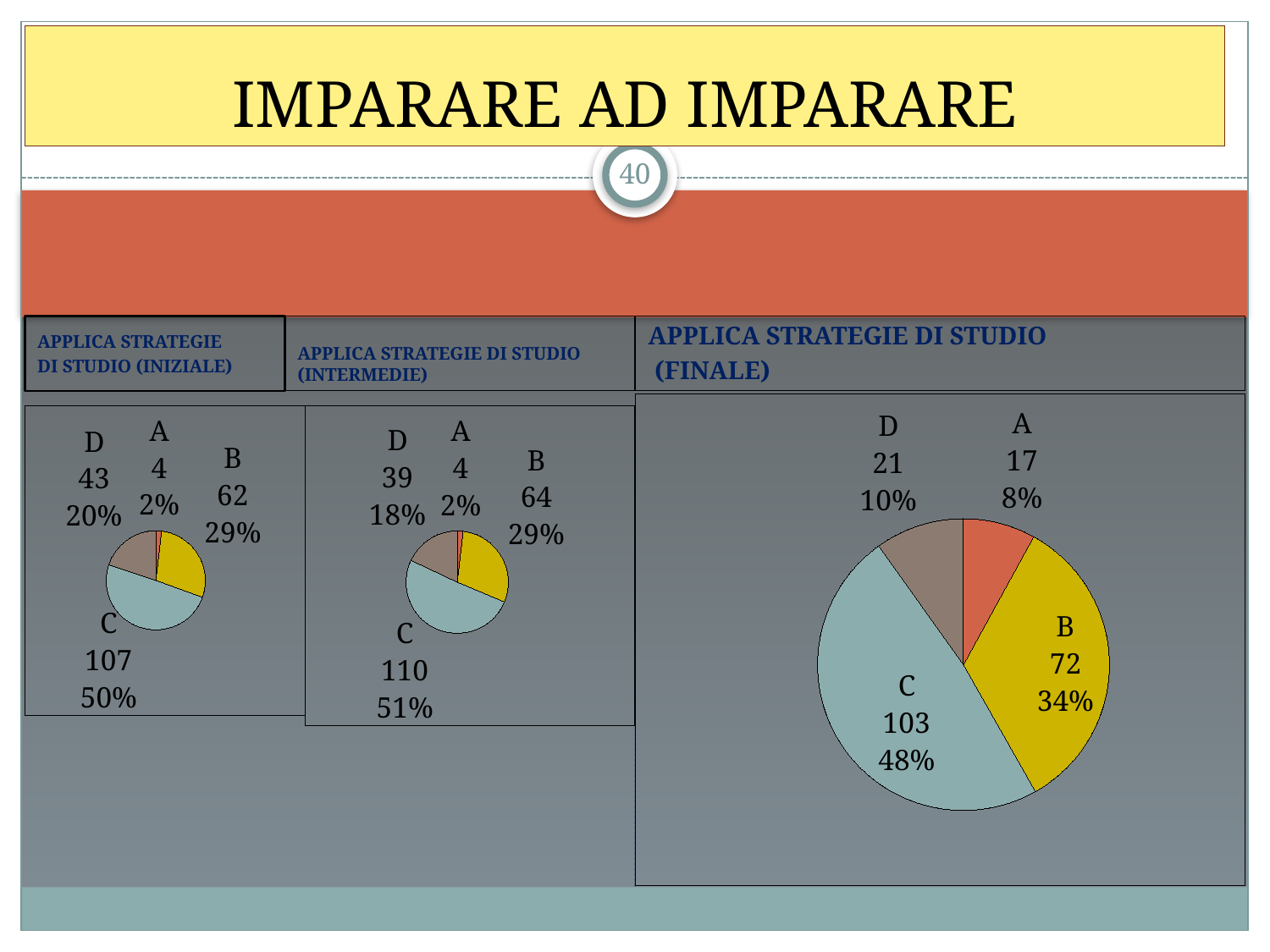
How many pie charts are shown on the slide? 3 In the APPLICA STRATEGIE DI STUDIO (FINALE) chart, what share of the pie does B represent? 34% What kind of chart is the APPLICA STRATEGIE DI STUDIO (INIZIALE) chart? Pie chart In the APPLICA STRATEGIE DI STUDIO (FINALE) chart, what is the difference between the values for C and B? 31 In the APPLICA STRATEGIE DI STUDIO (INIZIALE) chart, what is the value for D? 43 How many categories does the APPLICA STRATEGIE DI STUDIO (FINALE) chart show? 4 In the APPLICA STRATEGIE DI STUDIO (INIZIALE) chart, what share of the pie does A represent? 2% In the APPLICA STRATEGIE DI STUDIO (INIZIALE) chart, which category has the largest slice? C In the APPLICA STRATEGIE DI STUDIO (INTERMEDIE) chart, which is larger, the value for B or the value for D? B In the APPLICA STRATEGIE DI STUDIO (FINALE) chart, what is the value for C? 103 In the APPLICA STRATEGIE DI STUDIO (INTERMEDIE) chart, what is the value for C? 110 In the APPLICA STRATEGIE DI STUDIO (FINALE) chart, which category has the smallest slice? A